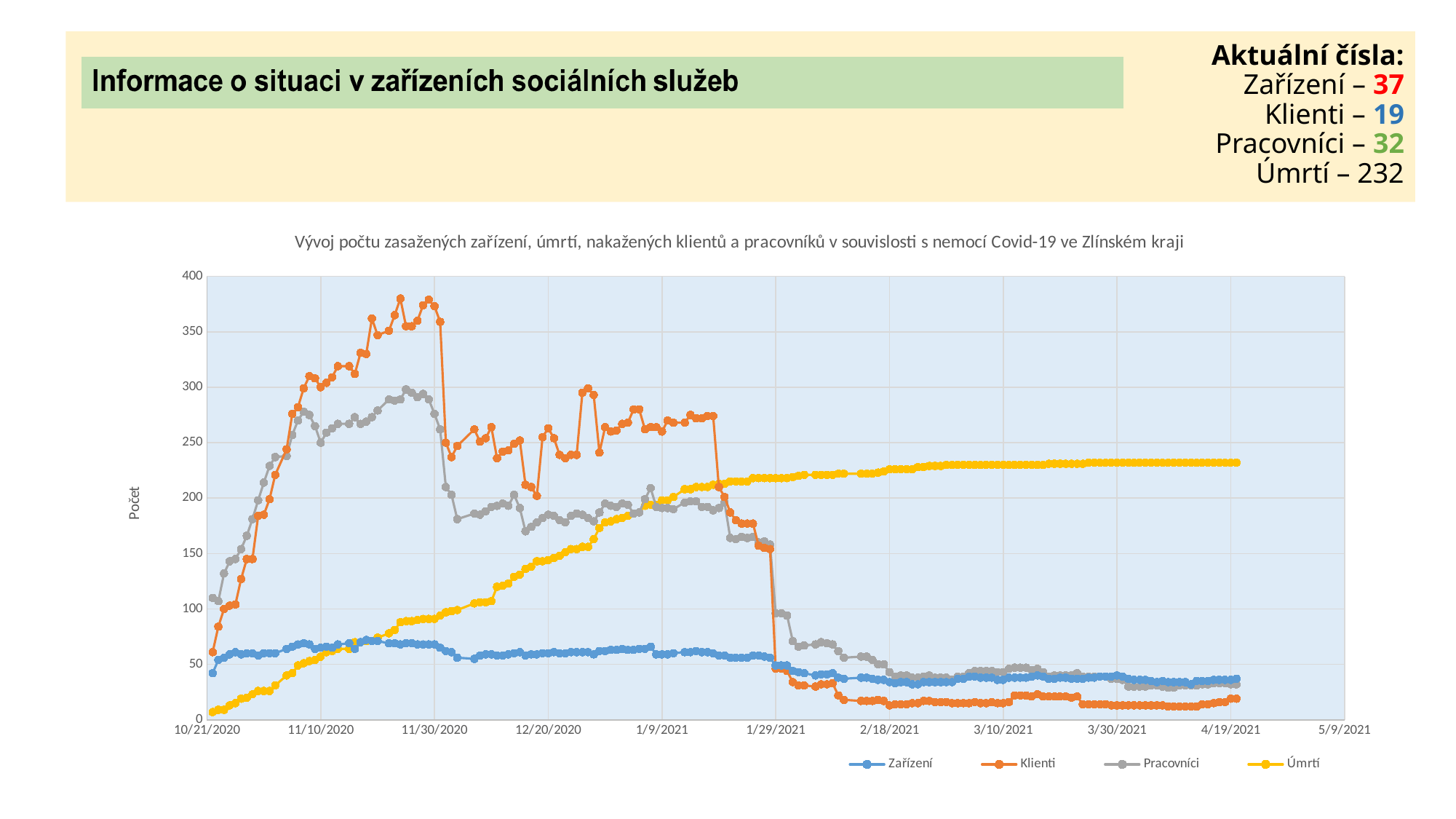
What kind of chart is shown on the slide? line chart Does the Klienti series rise or fall between 1/9/2021 and 4/19/2021? falls Is the highest value reached by the Zařízení series greater or less than 100? less At 11/30/2020, which series has the larger value, Klienti or Zařízení? Klienti How many series does the chart legend list? 4 Is the value of Úmrtí at 4/19/2021 greater or less than 200? greater Which series reaches the highest value anywhere on the chart? Klienti Is the value of Klienti at 4/19/2021 greater or less than 50? less What is the label on the vertical axis of the chart? Počet Which series has the lowest value at the last date plotted (4/19/2021)? Klienti Does the Úmrtí series rise or fall along the x axis? rises Which series has the highest value at the last date plotted (4/19/2021)? Úmrtí